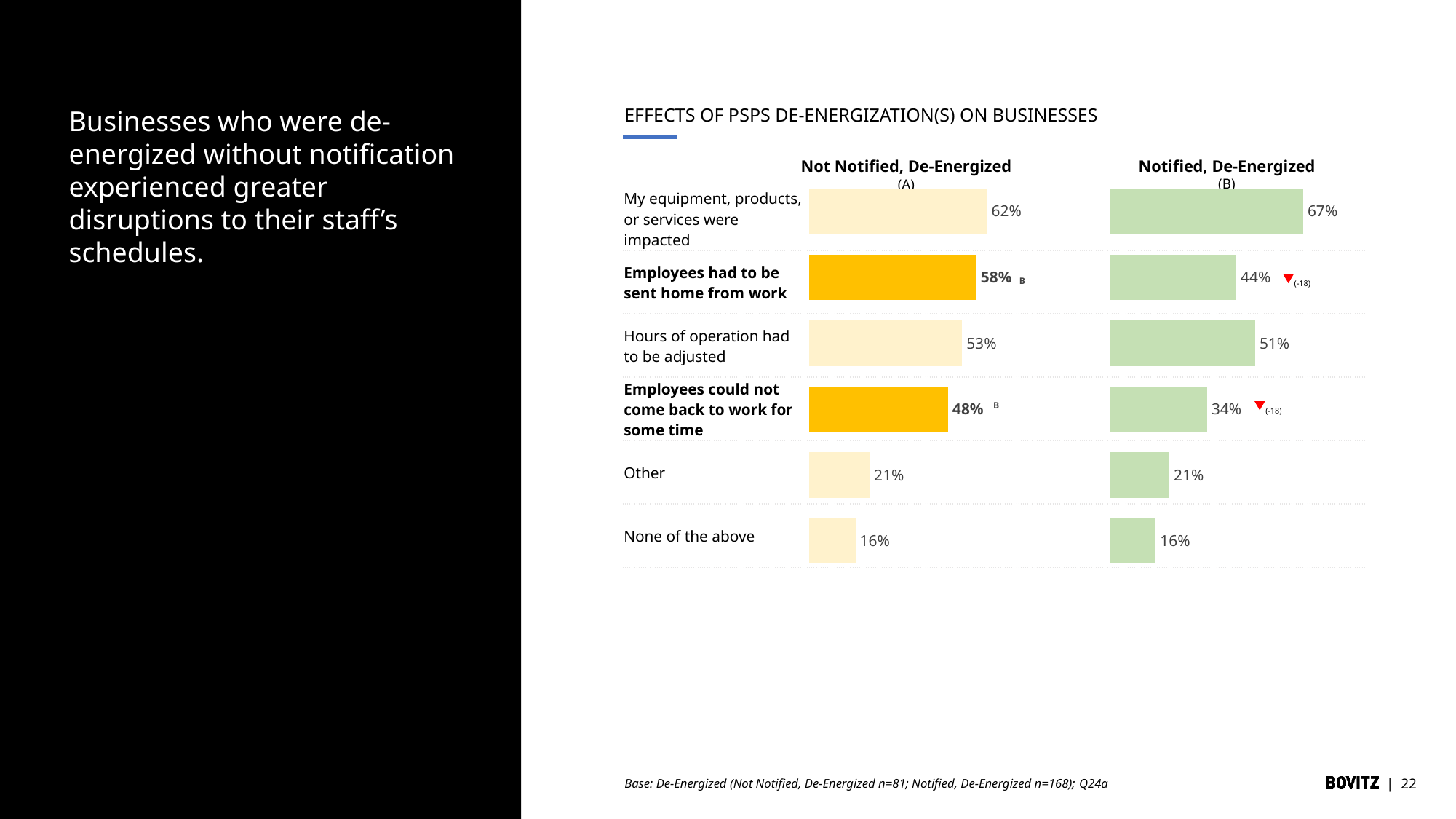
What percentage of Not Notified, De-Energized businesses said employees had to be sent home from work? 58% What percentage of Notified, De-Energized businesses said their equipment, products, or services were impacted? 67% What is the difference between the Not Notified and Notified percentages for 'Employees had to be sent home from work'? 14 percentage points What type of chart is shown on the slide? Bar chart For 'My equipment, products, or services were impacted', which group has the larger percentage: Not Notified or Notified? Notified, De-Energized How many effect categories are listed in the chart? 6 Which effect has the highest percentage among Not Notified, De-Energized businesses? My equipment, products, or services were impacted For 'Hours of operation had to be adjusted', which group has the larger percentage: Not Notified or Notified? Not Notified, De-Energized What percentage of Notified, De-Energized businesses said employees could not come back to work for some time? 34% Which effect has the lowest percentage among Notified, De-Energized businesses? None of the above What is the title of the chart? EFFECTS OF PSPS DE-ENERGIZATION(S) ON BUSINESSES What is the difference between the Not Notified and Notified percentages for 'Employees could not come back to work for some time'? 14 percentage points